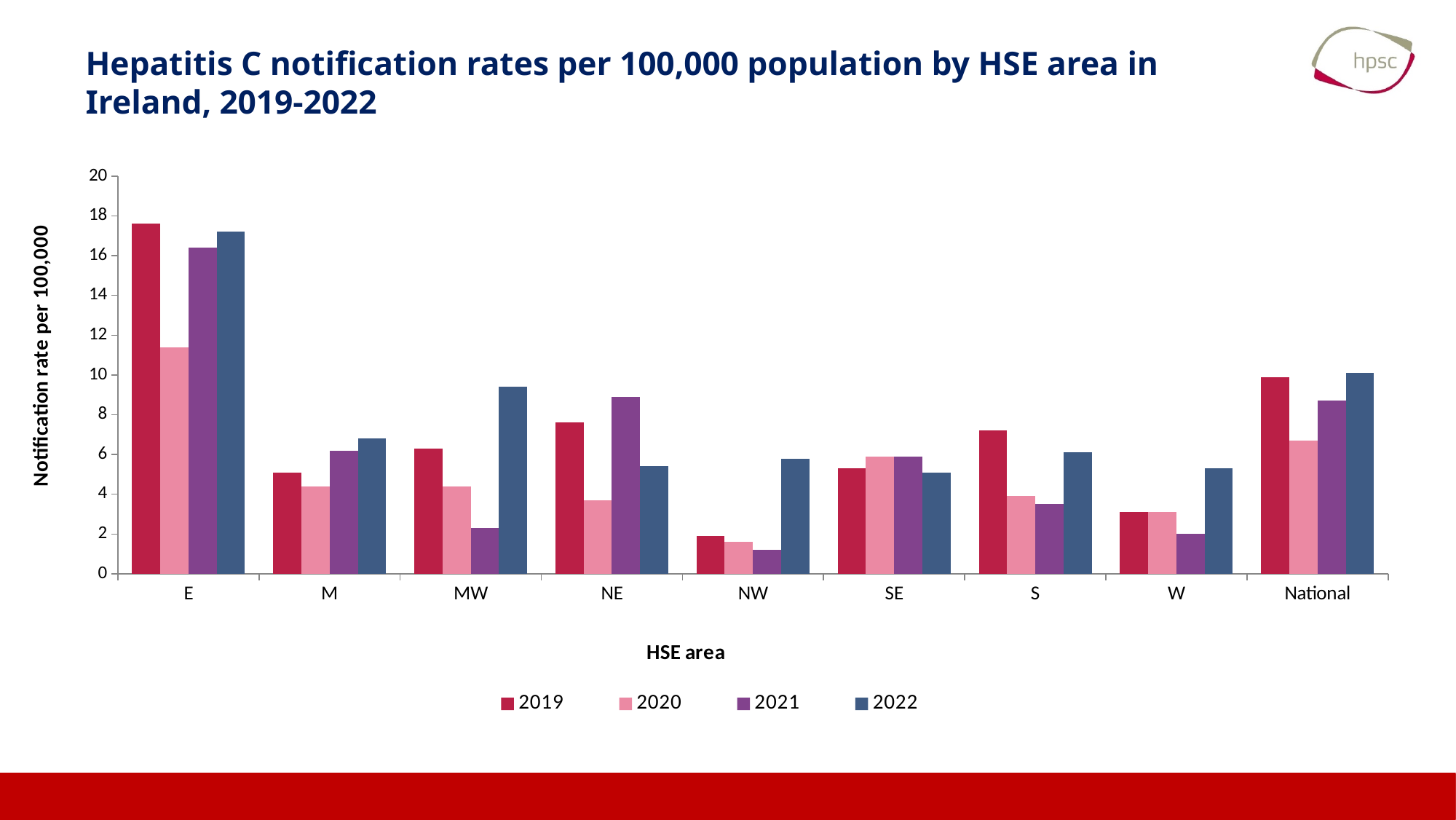
For NE, which year has the larger value, 2019 or 2021? 2021 Which HSE area has the highest 2019 notification rate? E Is the 2021 value for NW greater or less than 2? less Is the 2022 value for MW greater or less than 8? greater What kind of chart is shown on the slide? Bar chart Which HSE area has the highest 2022 notification rate? E Which HSE area has the lowest 2019 notification rate? NW How many series does the legend list? 4 Is the 2019 value for E greater or less than 16? greater For MW, which year has the larger value, 2021 or 2022? 2022 How many HSE areas (categories) are shown on the x axis? 9 What is the label of the y axis? Notification rate per 100,000